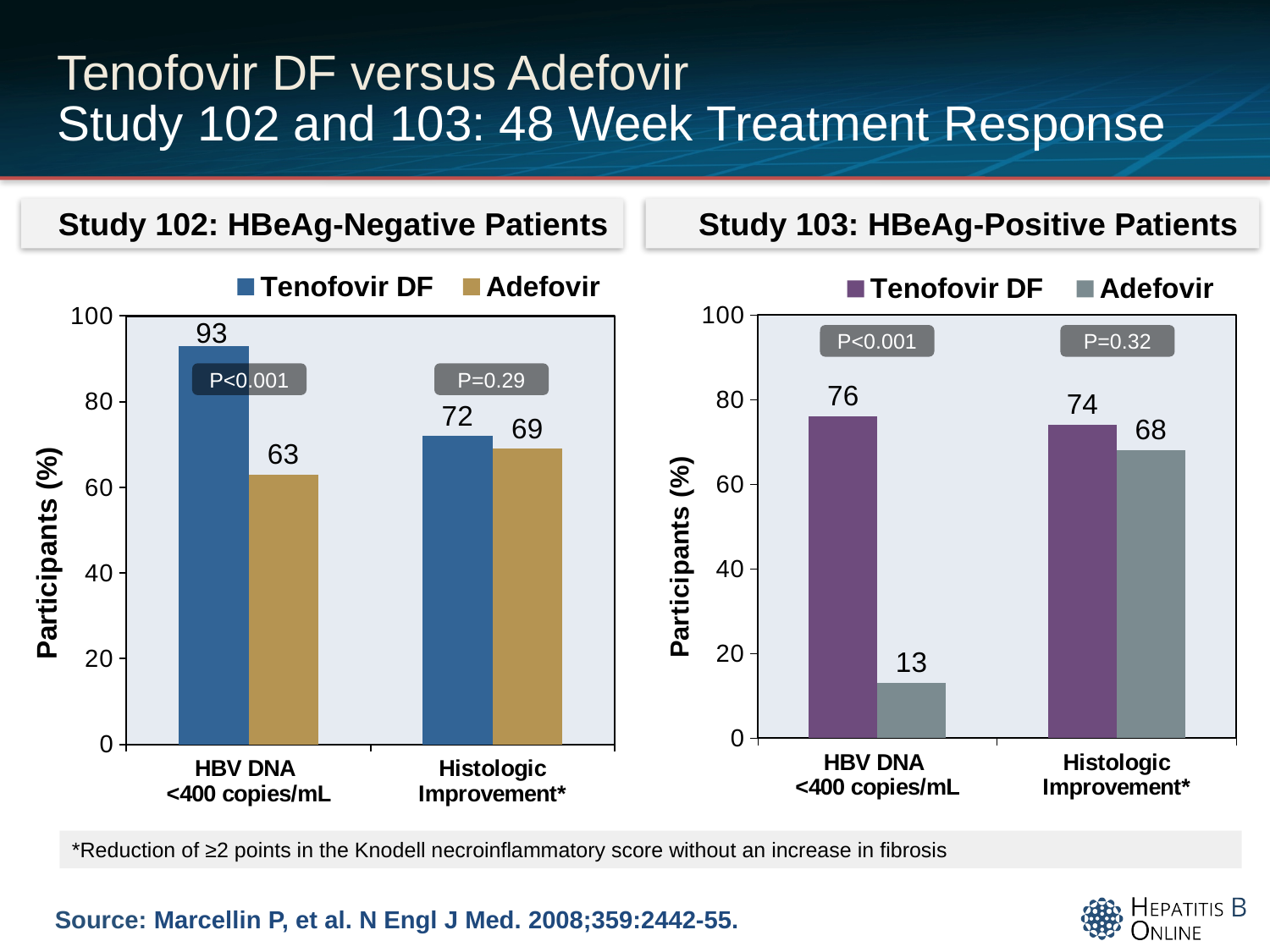
In the Study 103: HBeAg-Positive Patients chart, what is the difference between Tenofovir DF and Adefovir for HBV DNA <400 copies/mL? 63 How many series does the legend of the Study 102: HBeAg-Negative Patients chart list? 2 In the Study 102: HBeAg-Negative Patients chart, what is the difference between Tenofovir DF and Adefovir for HBV DNA <400 copies/mL? 30 What is the y-axis label of the Study 102: HBeAg-Negative Patients chart? Participants (%) In the Study 103: HBeAg-Positive Patients chart, which is larger for Histologic Improvement*: Tenofovir DF or Adefovir? Tenofovir DF In the Study 103: HBeAg-Positive Patients chart, what is the value for Tenofovir DF for Histologic Improvement*? 74 In the Study 102: HBeAg-Negative Patients chart, what is the value for Tenofovir DF for HBV DNA <400 copies/mL? 93 In the Study 102: HBeAg-Negative Patients chart, which bar is the highest? Tenofovir DF, HBV DNA <400 copies/mL What kind of chart is the Study 103: HBeAg-Positive Patients chart? Bar chart In the Study 102: HBeAg-Negative Patients chart, what is the value for Adefovir for Histologic Improvement*? 69 In the Study 103: HBeAg-Positive Patients chart, what is the value for Adefovir for HBV DNA <400 copies/mL? 13 In the Study 103: HBeAg-Positive Patients chart, which bar is the lowest? Adefovir, HBV DNA <400 copies/mL